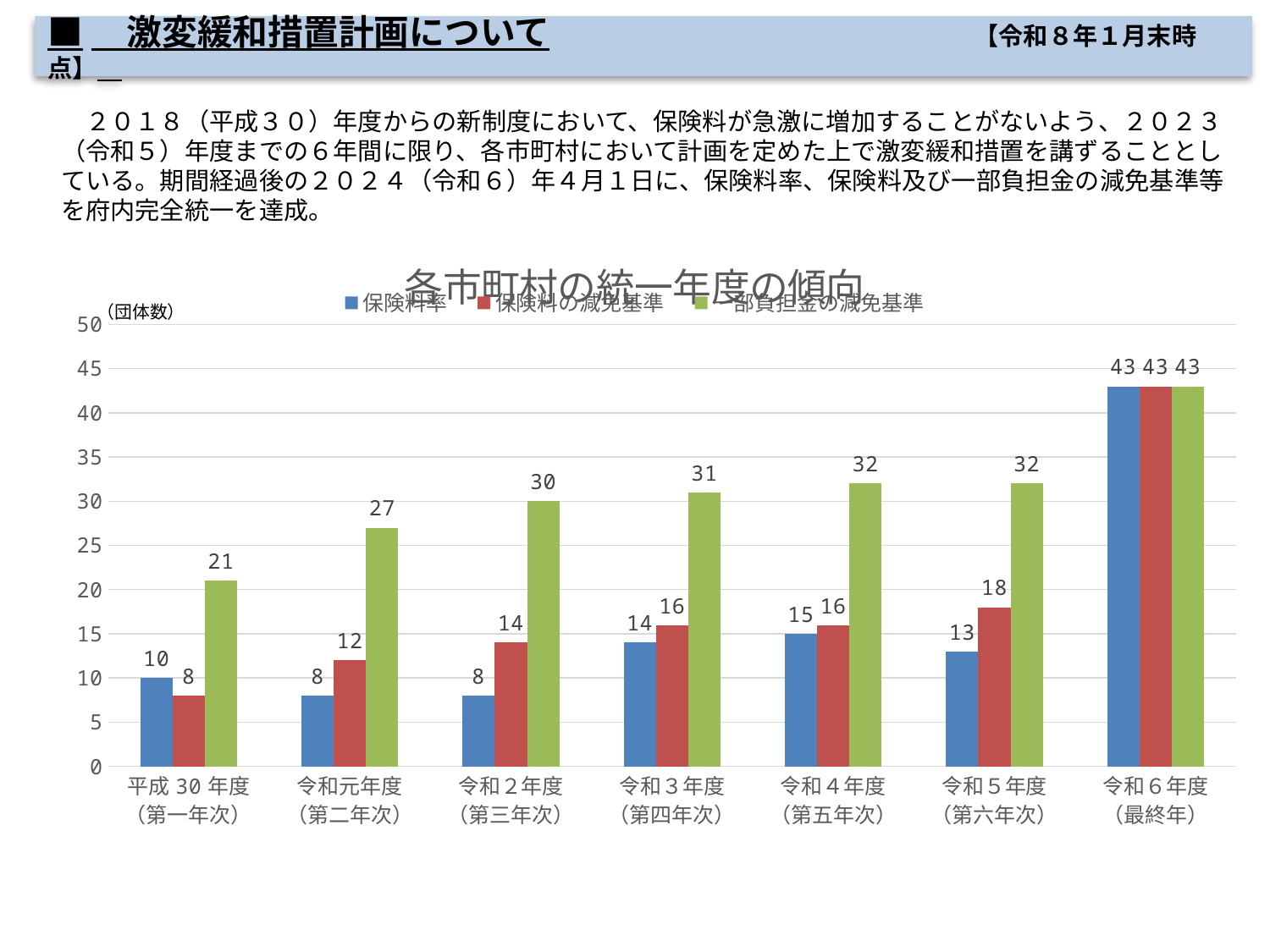
What is the value of 保険料率 for 平成30年度（第一年次）? 10 Which category has the lowest value for 一部負担金の減免基準? 平成30年度（第一年次） Which is larger for 令和3年度（第四年次）: 保険料率 or 保険料の減免基準? 保険料の減免基準 What is the title of the chart? 各市町村の統一年度の傾向 What is the difference between 一部負担金の減免基準 and 保険料率 for 令和元年度（第二年次）? 19 What kind of chart is this? bar chart What is the value of 保険料の減免基準 for 令和5年度（第六年次）? 18 How many categories are shown on the x axis? 7 How many series does the legend list? 3 Does the value of 一部負担金の減免基準 rise or fall from 平成30年度 to 令和6年度? rise Which category has the highest value for 保険料率? 令和6年度（最終年） What is the value of 一部負担金の減免基準 for 令和2年度（第三年次）? 30